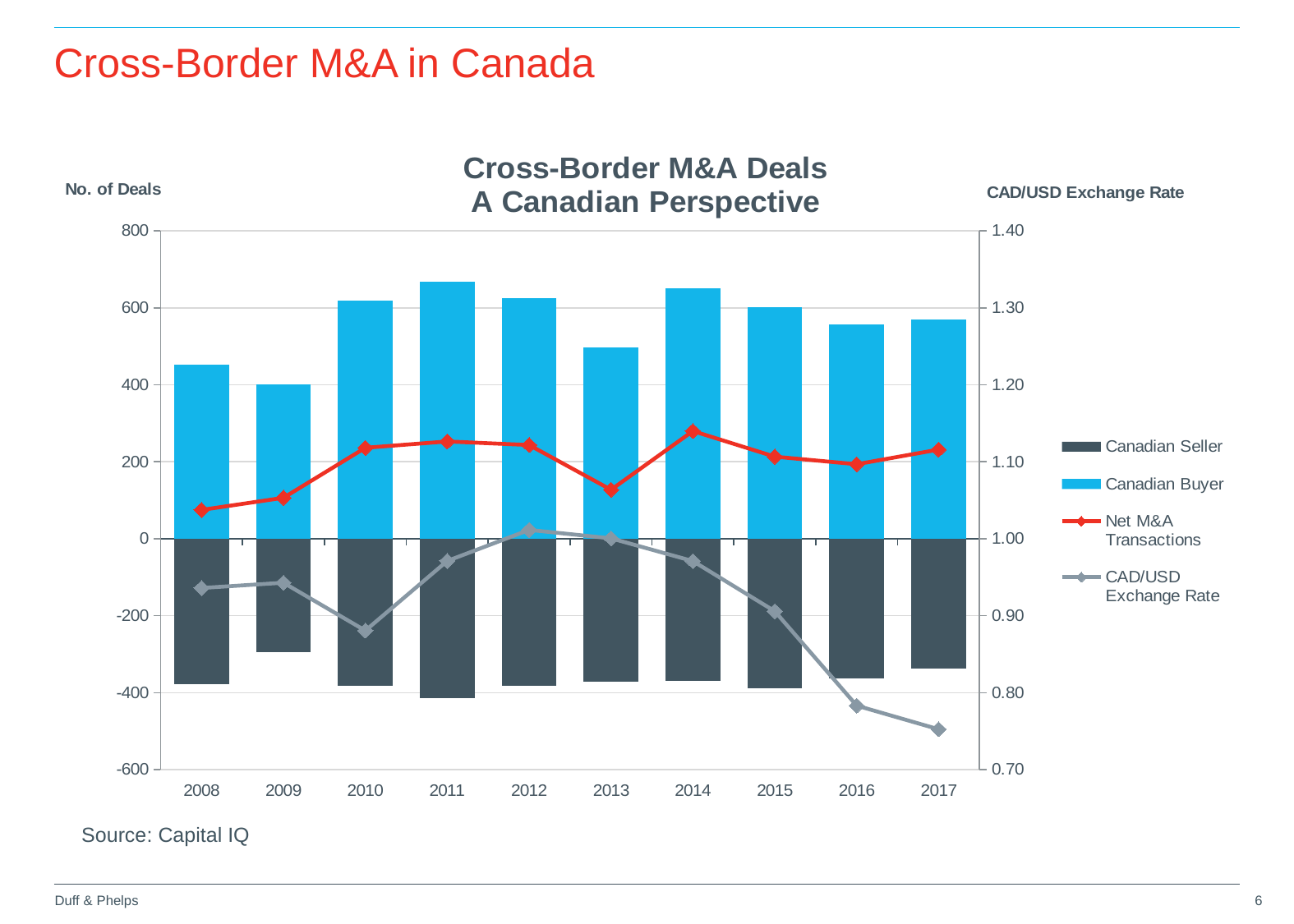
What kind of chart is this? Combination bar and line chart Which year has the lowest Canadian Buyer value? 2009 Is the Net M&A Transactions value for 2008 greater or less than 100? less Does the CAD/USD Exchange Rate rise or fall from 2012 to 2017? fall How many years are shown on the x axis? 10 Is the CAD/USD Exchange Rate for 2017 greater or less than 0.80? less How many series does the legend list? 4 Which year has the lowest CAD/USD Exchange Rate? 2017 Which year has the highest Net M&A Transactions value? 2014 Which year has the larger Canadian Buyer value, 2010 or 2013? 2010 Which year has the highest CAD/USD Exchange Rate? 2012 Is the Canadian Buyer value for 2010 greater or less than 600? greater